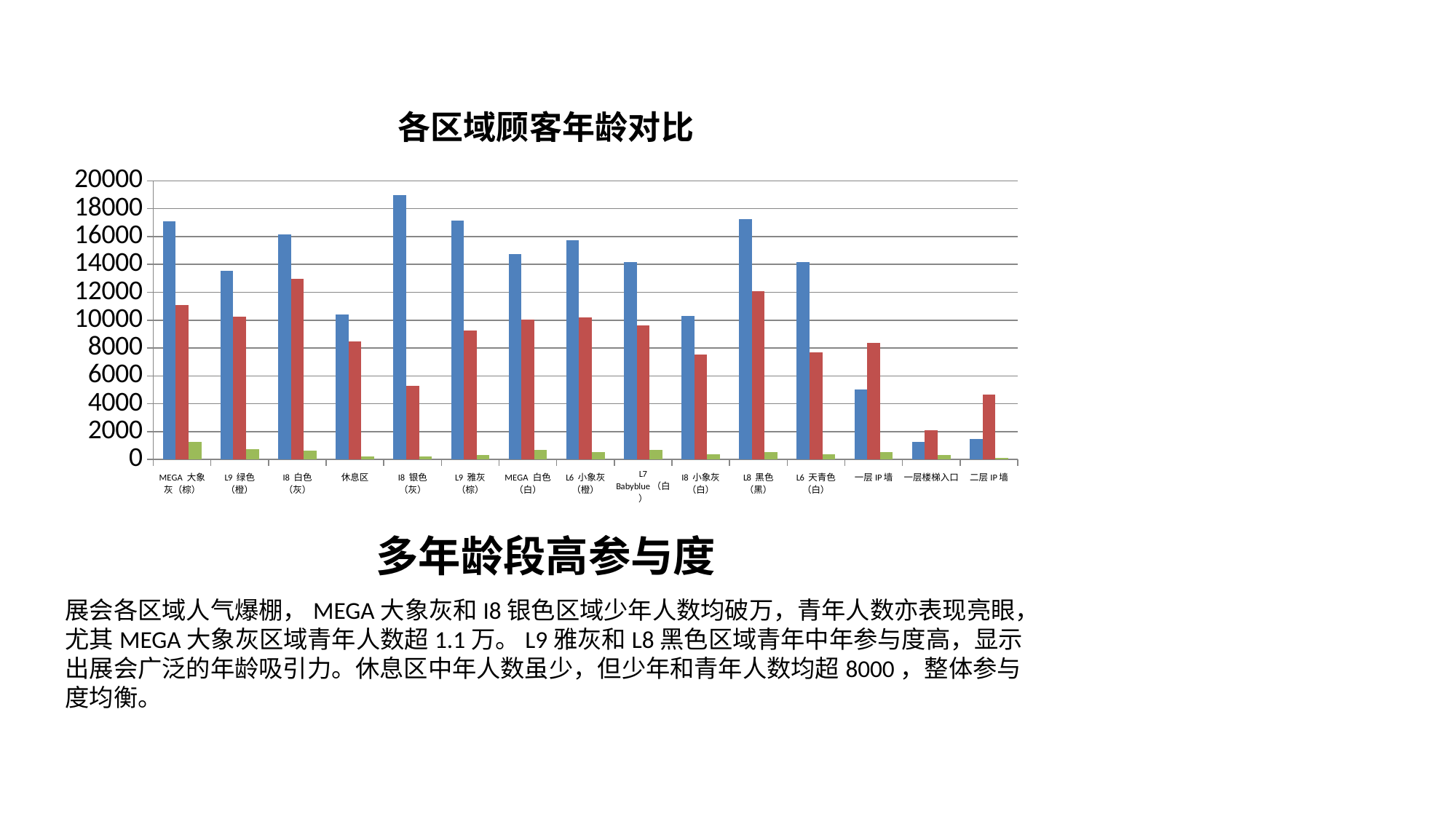
Which category has the highest blue bar? I8 银色（灰） Is the red bar for 休息区 greater or less than 8000? greater For 一层 IP 墙, which is larger, the blue bar or the red bar? the red bar What is the title of the chart? 各区域顾客年龄对比 Which category has the lowest red bar? 一层楼梯入口 Is the blue bar for 一层 IP 墙 greater or less than 6000? less Which has the larger blue bar, MEGA 大象灰（棕） or L9 绿色（橙）? MEGA 大象灰（棕） Is the blue bar for I8 银色（灰） greater or less than 18000? greater How many data series (bars per category) does the chart plot? 3 What type of chart is shown on the slide? bar chart How many categories are shown on the x axis of the chart? 15